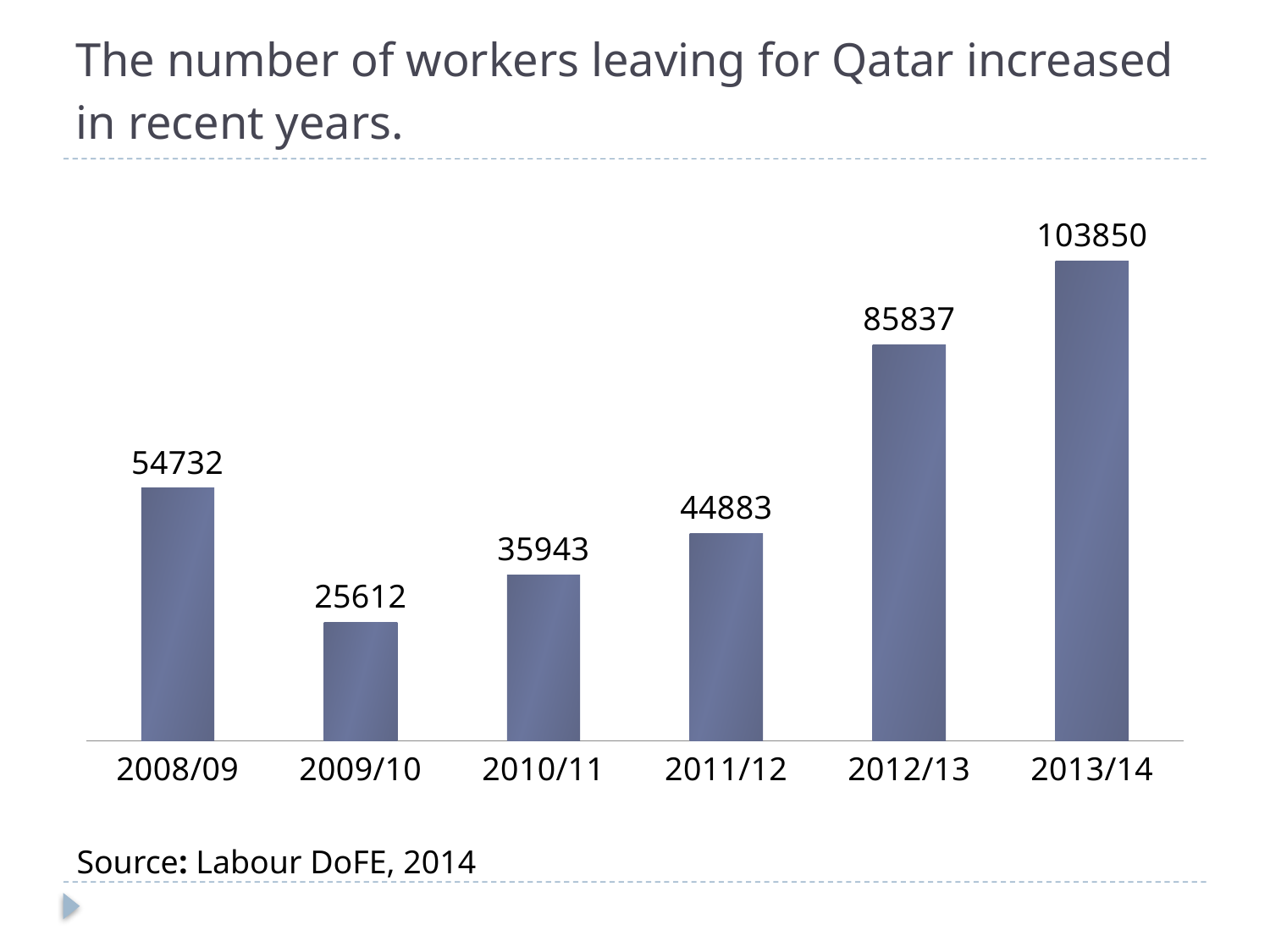
What kind of chart is shown on the slide? bar chart What is the difference between the values for 2013/14 and 2012/13? 18013 How many years are shown on the x axis? 6 Which year has the highest value? 2013/14 What is the difference between the values for 2008/09 and 2009/10? 29120 What is the value for 2013/14? 103850 What source is cited below the chart? Labour DoFE, 2014 What is the value for 2008/09? 54732 Do the values rise or fall from 2009/10 to 2013/14? rise What is the value for 2011/12? 44883 Which is larger, the value for 2008/09 or the value for 2011/12? 2008/09 Which year has the lowest value? 2009/10